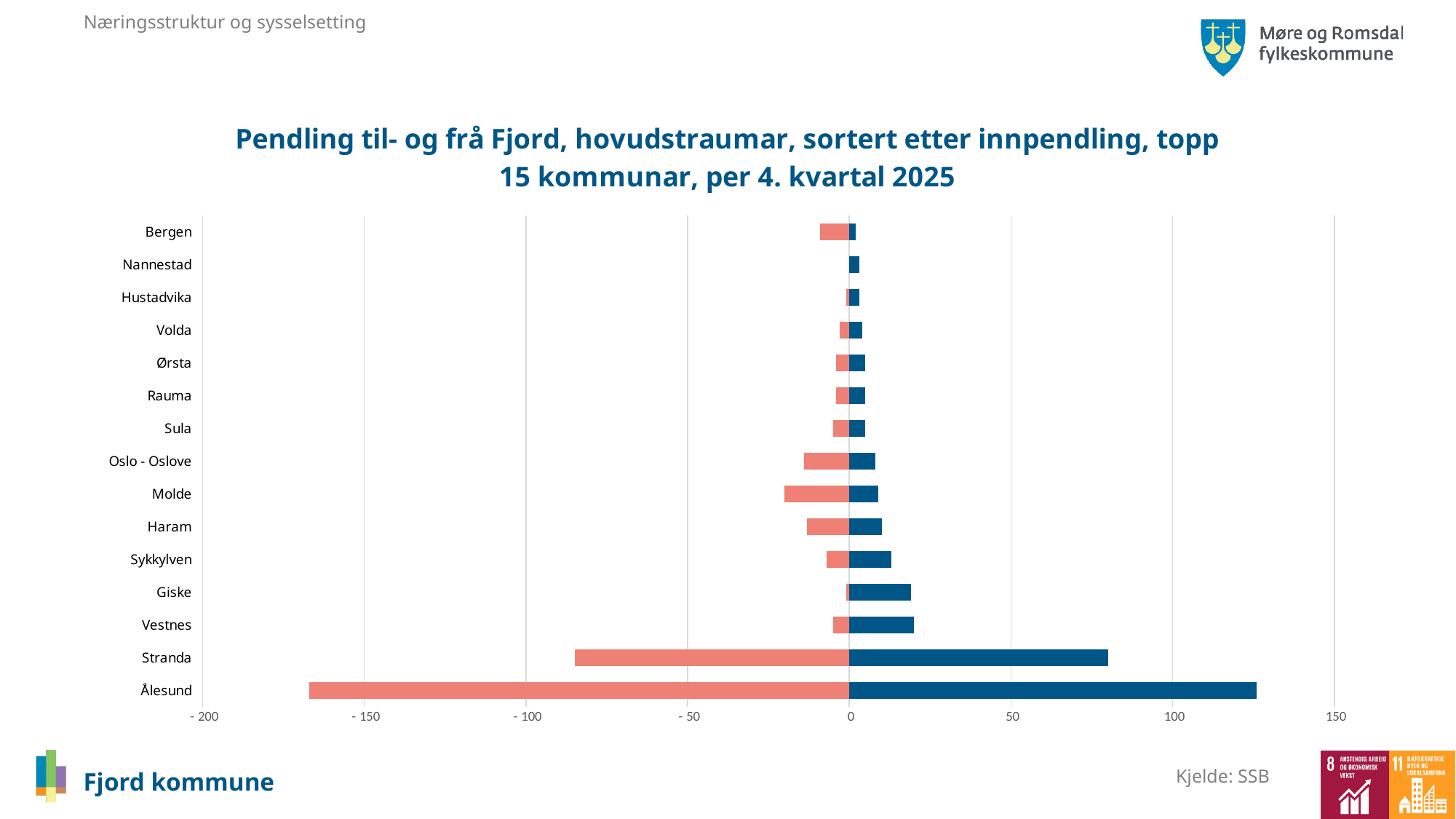
Which has the longer red bar, Stranda or Molde? Stranda Is the value of the blue bar for Stranda greater or less than 50? greater What type of chart is shown on the slide? bar chart How many municipalities are listed on the vertical axis of the chart? 15 Is the value of the blue bar for Ålesund greater or less than 100? greater Is the value of the blue bar for Vestnes greater or less than 50? less What is the title of the chart? Pendling til- og frå Fjord, hovudstraumar, sortert etter innpendling, topp 15 kommunar, per 4. kvartal 2025 Which municipality has the longest blue (positive) bar? Ålesund What are the lowest and highest tick values shown on the horizontal axis? -200 and 150 Which has the longer blue bar, Giske or Sykkylven? Giske